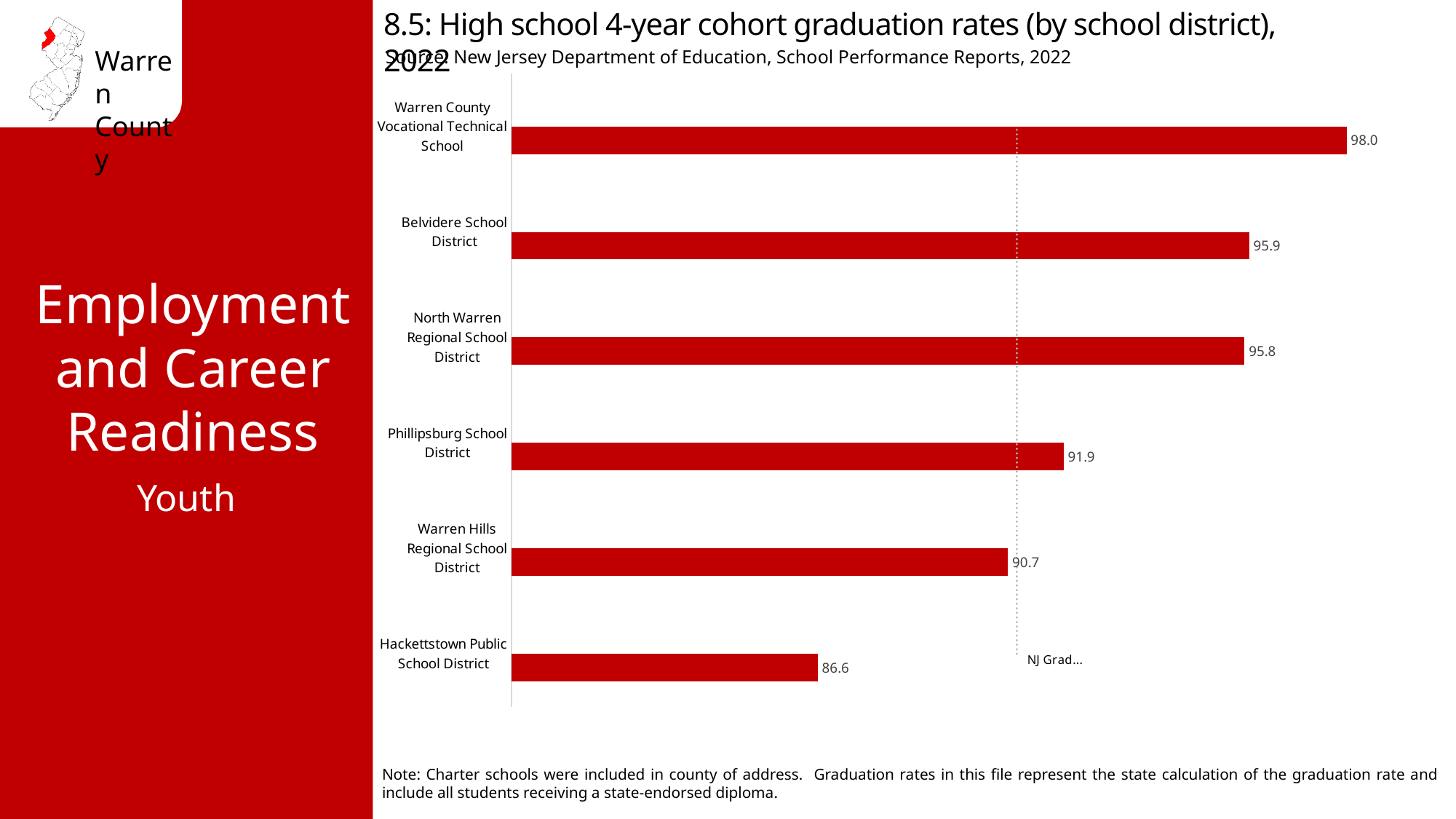
Which school district has the highest graduation rate? Warren County Vocational Technical School Which school district has the lowest graduation rate? Hackettstown Public School District What is the graduation rate for Warren Hills Regional School District? 90.7 What is the title of the chart? 8.5: High school 4-year cohort graduation rates (by school district), 2022 What type of chart is used on this slide? Bar chart What is the difference between the graduation rates of Belvidere School District and Phillipsburg School District? 4.0 What is the graduation rate for Hackettstown Public School District? 86.6 What is the graduation rate for Phillipsburg School District? 91.9 What is the graduation rate for Warren County Vocational Technical School? 98.0 What is the difference between the graduation rates of Warren County Vocational Technical School and Hackettstown Public School District? 11.4 How many school districts are shown in the chart? 6 Which has a higher graduation rate, Phillipsburg School District or Warren Hills Regional School District? Phillipsburg School District